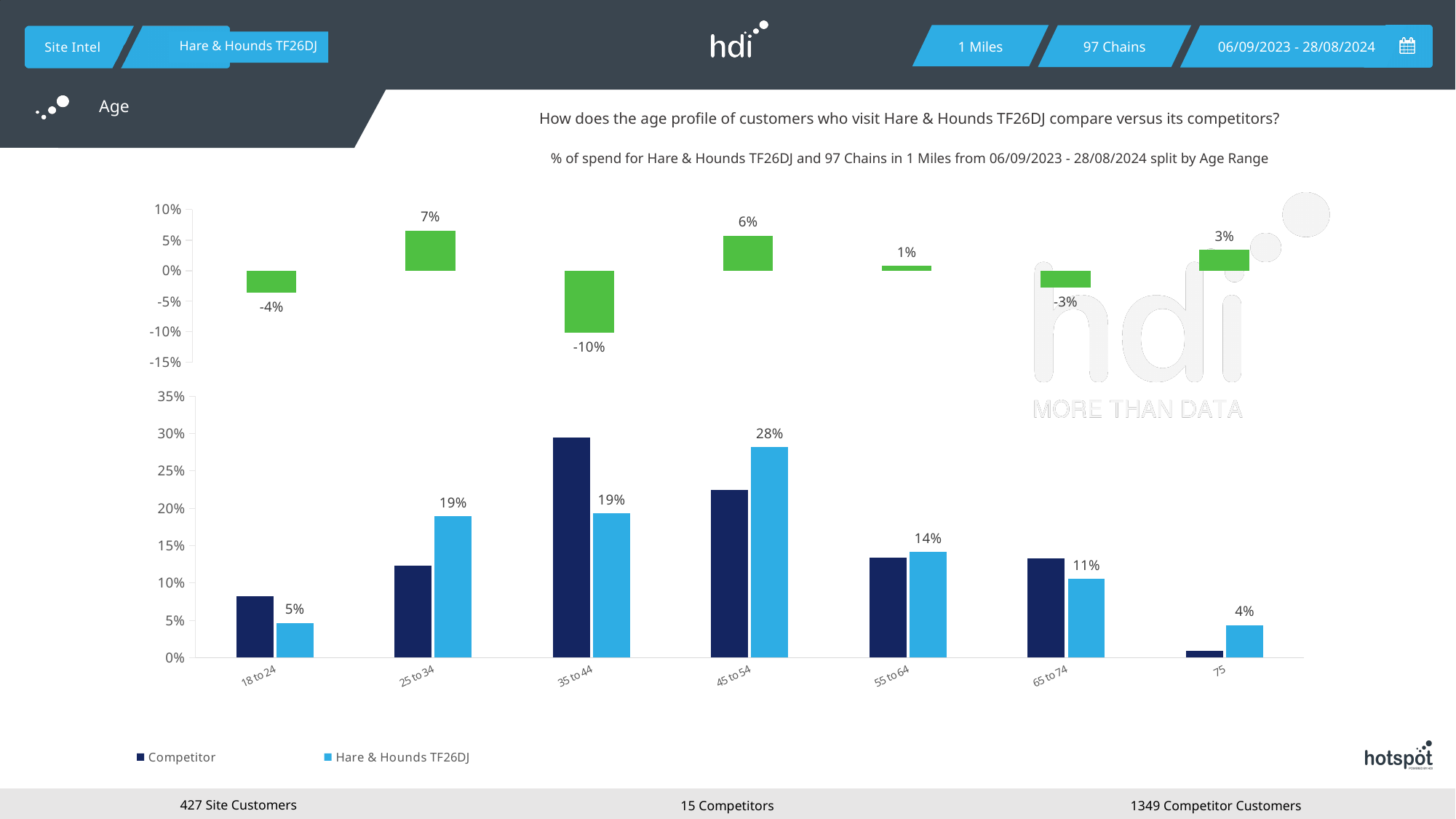
In the bottom chart, what is the difference between the Hare & Hounds TF26DJ values for 45 to 54 and 55 to 64? 14% In the bottom chart, for the 35 to 44 age range, which series has the larger value: Competitor or Hare & Hounds TF26DJ? Competitor In the bottom chart, which age range has the highest value for Hare & Hounds TF26DJ? 45 to 54 In the bottom chart, is the Competitor value for the 75 age range greater or less than 5%? less How many series does the legend of the bottom chart list? 2 How many age range categories are shown on the x axis of the bottom chart? 7 In the bottom chart, is the Competitor value for 35 to 44 greater or less than 25%? greater In the bottom chart, what is the value for Hare & Hounds TF26DJ in the 45 to 54 age range? 28%